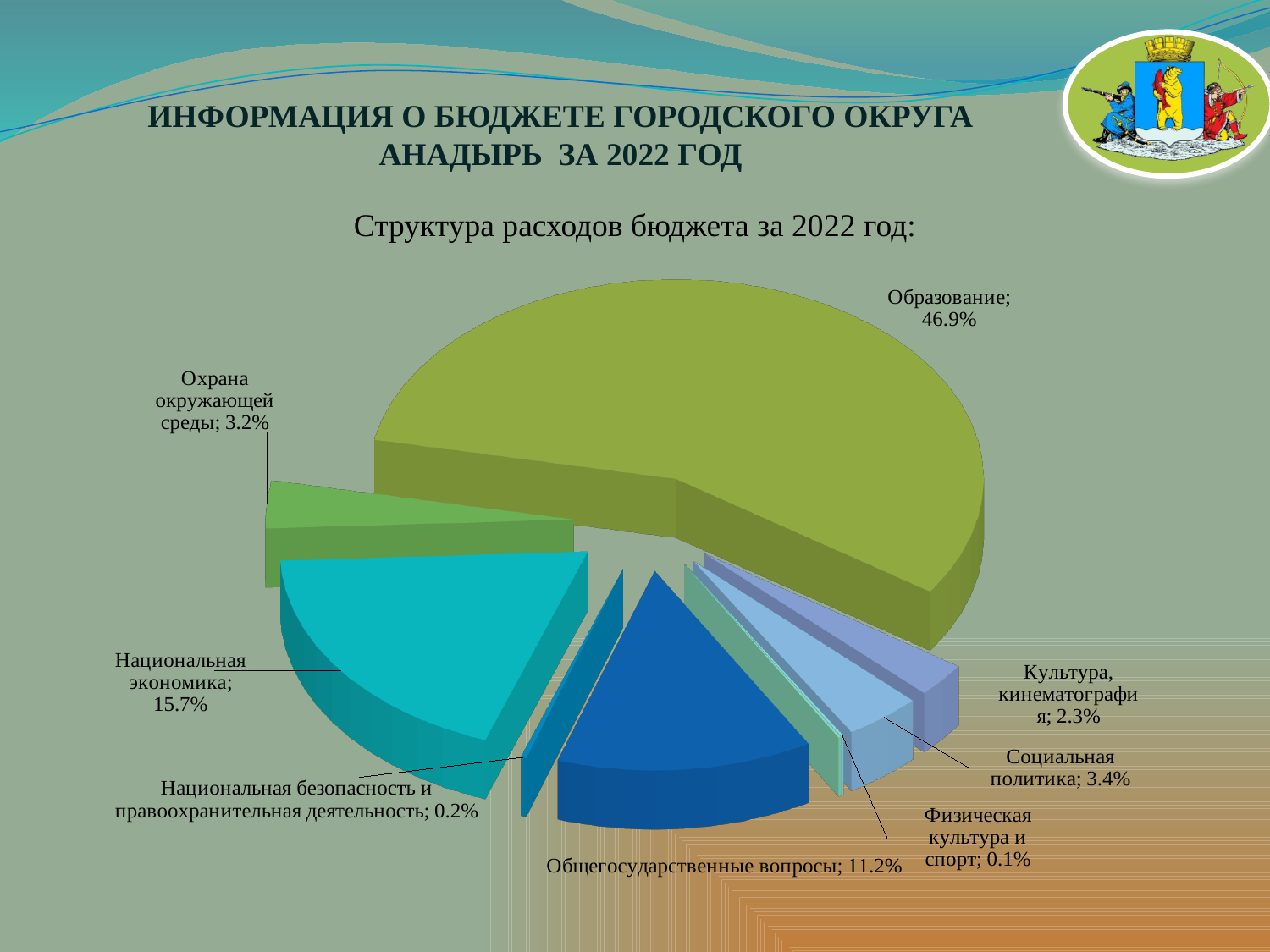
What is the value shown for Социальная политика? 3.4% How many categories (slices) are labelled on the pie chart? 8 What is the value shown for Физическая культура и спорт? 0.1% What kind of chart is shown on the slide? Pie chart Which is larger: the share for Охрана окружающей среды or the share for Культура, кинематография? Охрана окружающей среды What is the value shown for Общегосударственные вопросы? 11.2% What is the title of the chart? Структура расходов бюджета за 2022 год What is the difference between the shares of Национальная экономика and Общегосударственные вопросы? 4.5% Which category has the largest slice of the pie? Образование Which category has the smallest slice of the pie? Физическая культура и спорт What share of budget expenditure is labelled for Образование? 46.9% What is the value shown for Национальная экономика? 15.7%